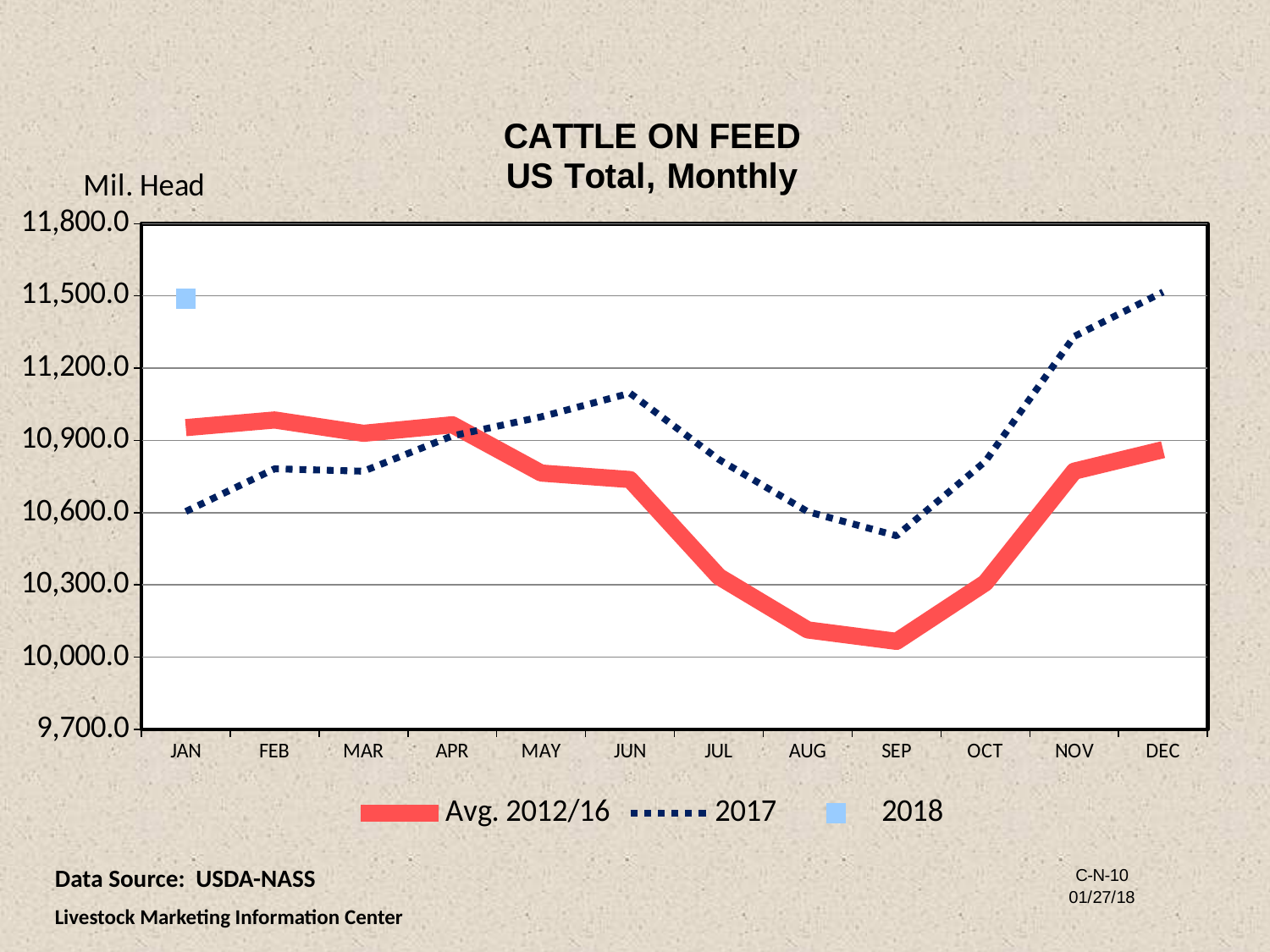
How many months are shown along the x axis? 12 Is the value for 2017 in NOV greater or less than 11,200.0? greater Does the 2017 series rise or fall from SEP to DEC? rise What unit label is shown above the y axis? Mil. Head In JAN, which is higher: Avg. 2012/16 or 2017? Avg. 2012/16 Is the value for Avg. 2012/16 in AUG greater or less than 10,300.0? less In which month is the 2017 series at its highest? DEC What is the title of the chart? CATTLE ON FEED US Total, Monthly What kind of chart is shown on the slide? line chart In which month is the Avg. 2012/16 series at its lowest? SEP Is the value for 2018 in JAN greater or less than 11,200.0? greater How many series does the legend list? 3